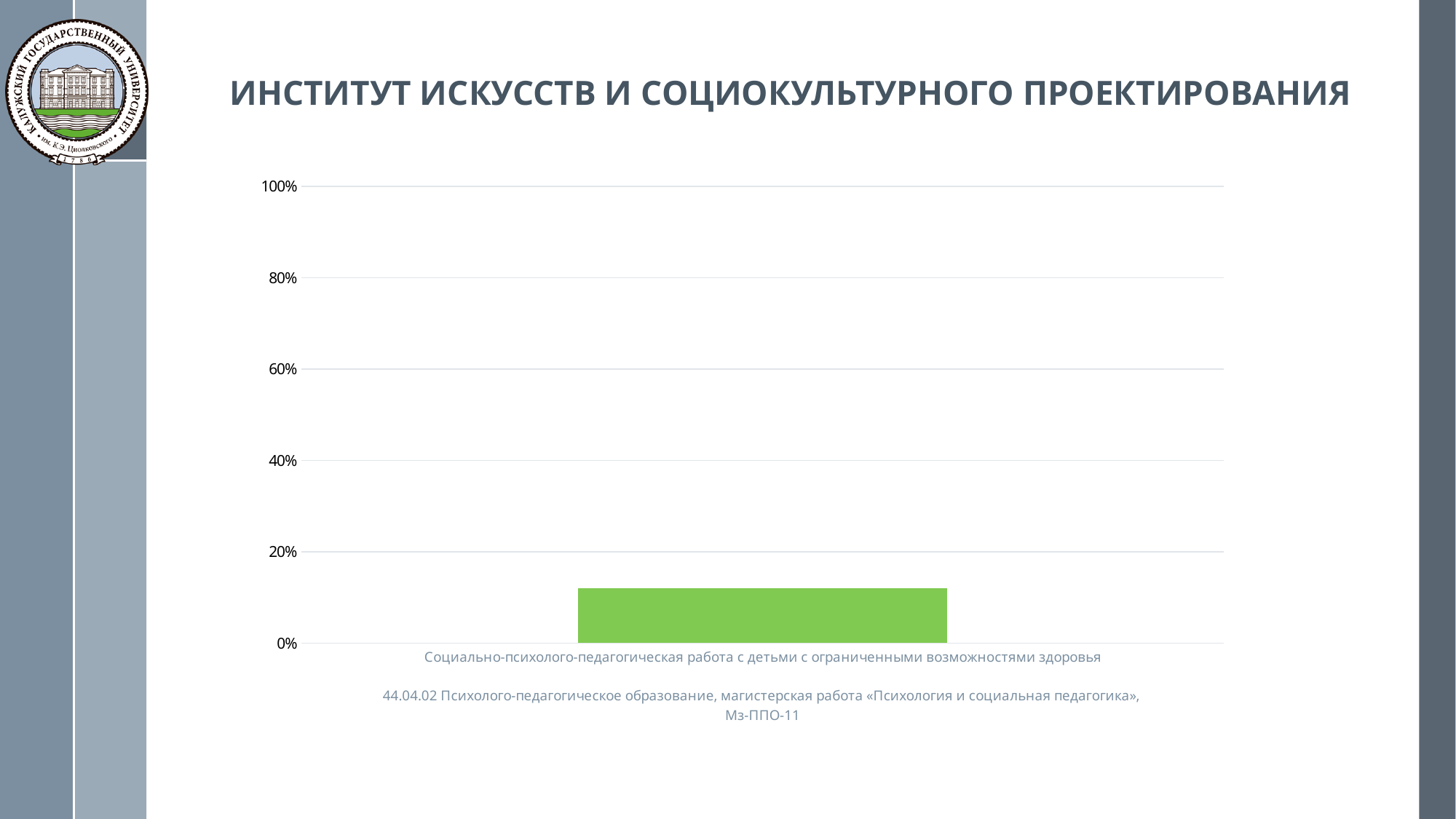
What colour is the bar in the chart? green How many bars are plotted in the chart? 1 Is the value for «Социально-психолого-педагогическая работа с детьми с ограниченными возможностями здоровья» greater or less than 20%? less Is the value for «Социально-психолого-педагогическая работа с детьми с ограниченными возможностями здоровья» greater or less than 40%? less What is the highest value shown on the vertical axis of the chart? 100% What kind of chart is shown on the slide? bar chart